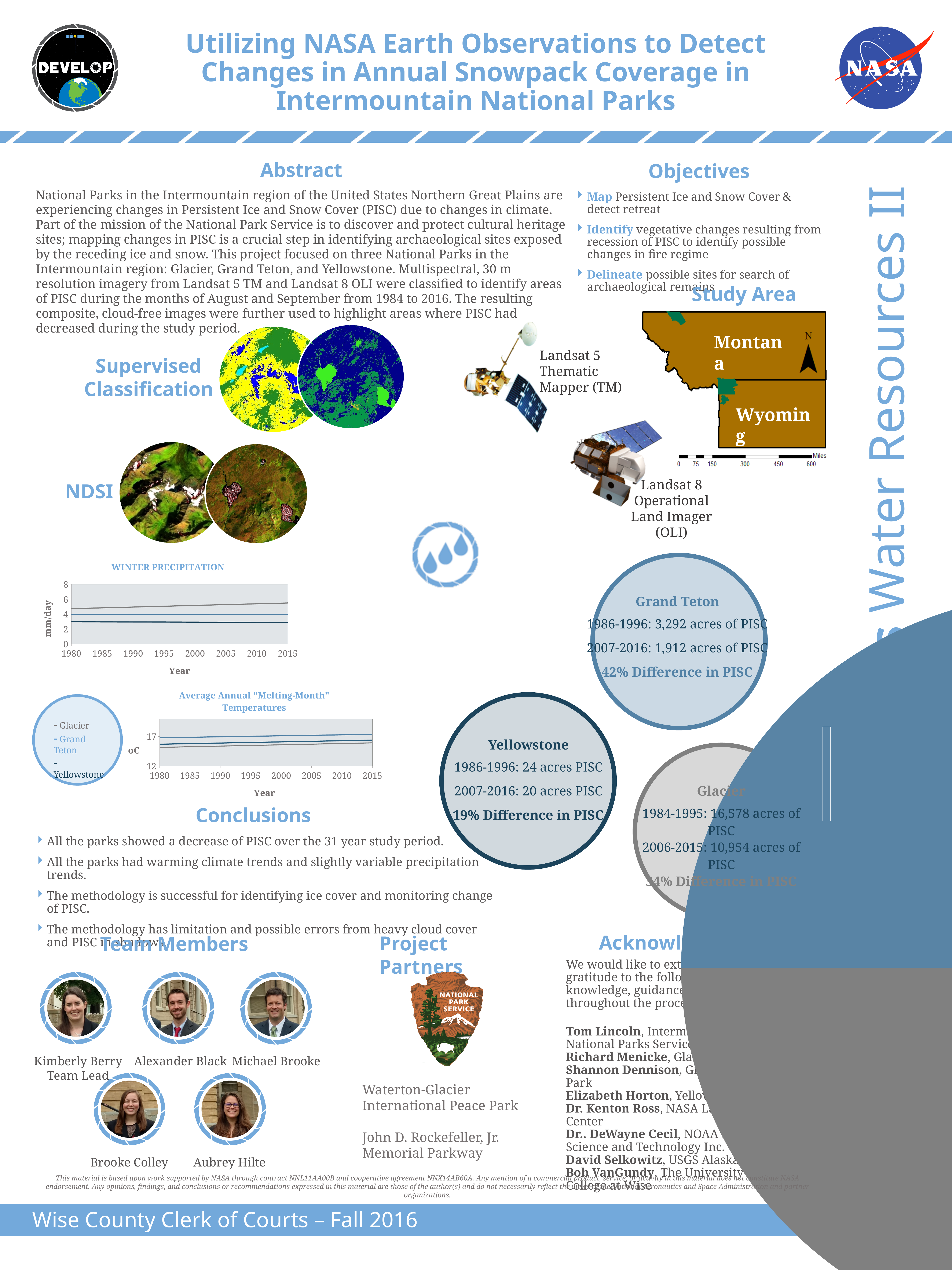
In the "Average Annual "Melting-Month" Temperatures" chart, do the lines rise or fall from 1980 to 2015? rise How many year ticks are shown on the x axis of the "WINTER PRECIPITATION" chart? 8 Which three parks are listed in the legend for the charts? Glacier, Grand Teton, Yellowstone What is the first year shown on the x axis of the "Average Annual "Melting-Month" Temperatures" chart? 1980 In the "Average Annual "Melting-Month" Temperatures" chart, are the plotted values greater or less than 12? greater How many series does the legend next to the charts list? 3 What kind of chart is the "Average Annual "Melting-Month" Temperatures" chart? line chart In the "WINTER PRECIPITATION" chart, is the value of the lowest line in 1980 greater or less than 4? less What kind of chart is the "WINTER PRECIPITATION" chart? line chart What is the y-axis label of the "WINTER PRECIPITATION" chart? mm/day In the "WINTER PRECIPITATION" chart, does the topmost line rise or fall from 1980 to 2015? rise In the "WINTER PRECIPITATION" chart, is the value of the topmost line in 2015 greater or less than 6? less